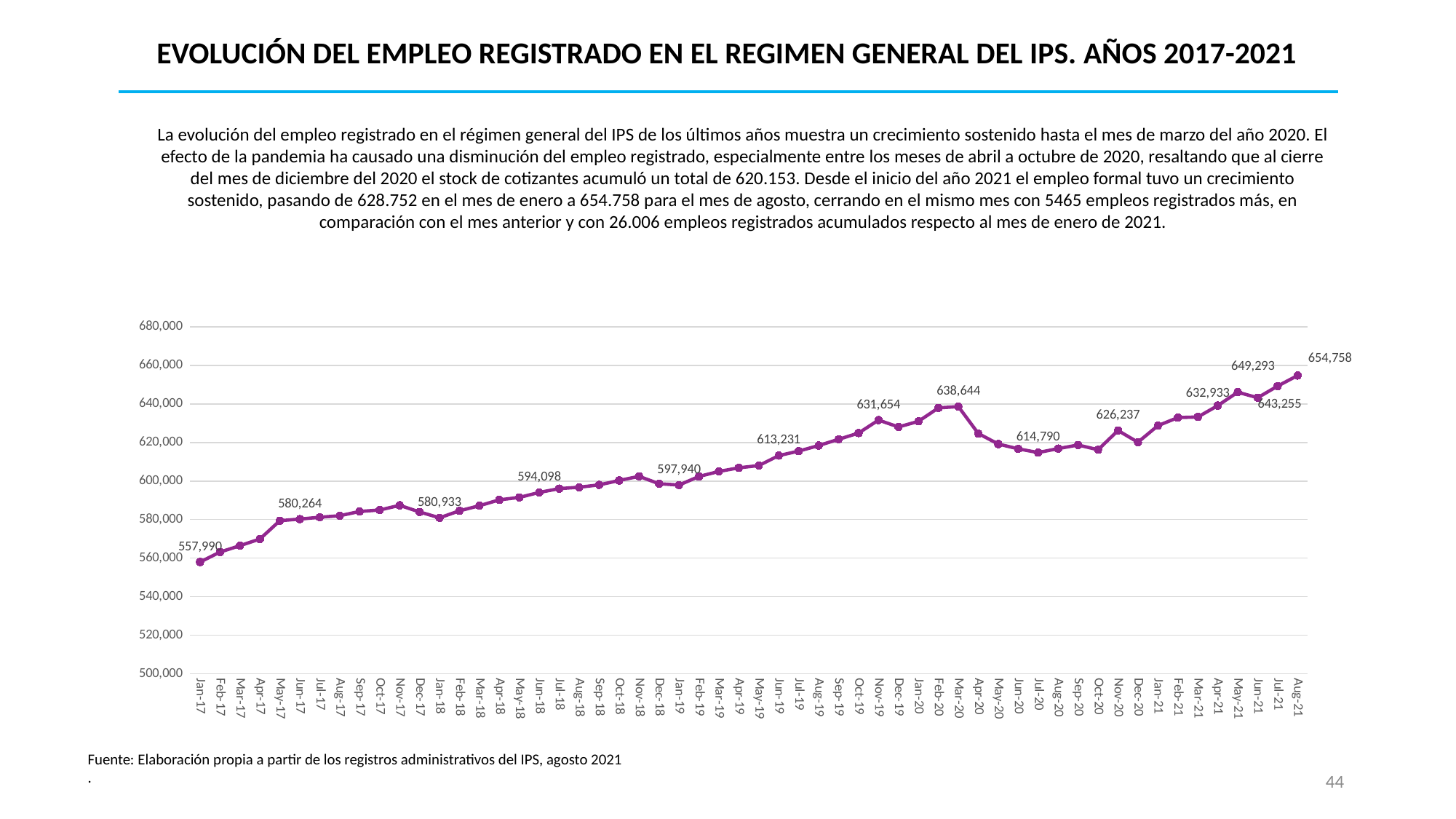
Which is larger, the value for Mar-20 or the value for Nov-20? Mar-20 Is the value for Jan-18 greater or less than 600,000? less Which month has the highest value on the chart? Aug-21 How many monthly data points are plotted on the chart? 56 What type of chart is shown on the slide? Line chart What is the value for Aug-21? 654,758 What is the value for Jan-17? 557,990 What is the value for Mar-20? 638,644 Which month has the lowest value on the chart? Jan-17 What is the difference between the values for Aug-21 and Jan-17? 96,768 What is the value for Jul-20? 614,790 What is the value for Nov-19? 631,654